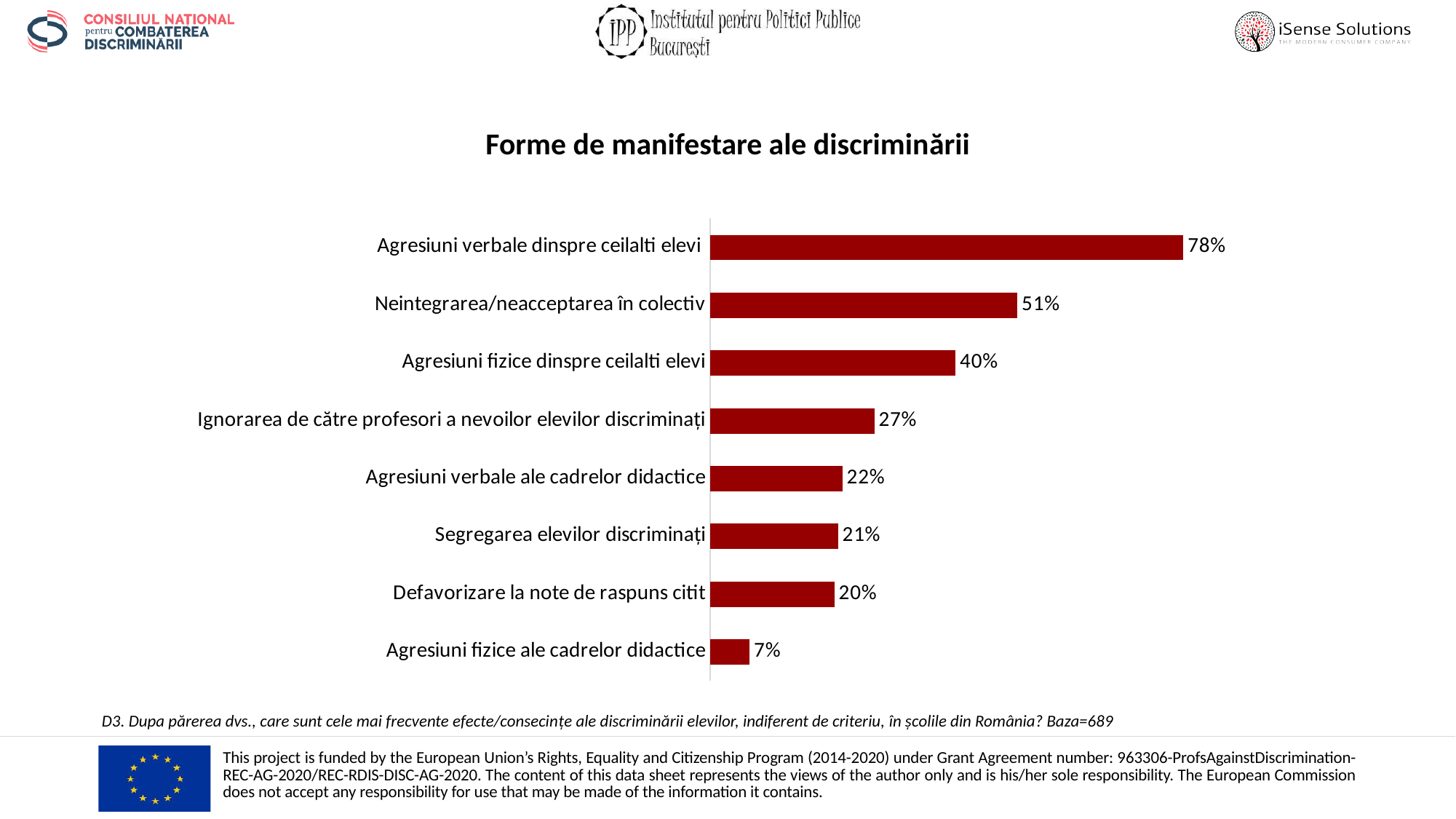
Which category has the lowest value? Agresiuni fizice ale cadrelor didactice What is the difference between the values for "Neintegrarea/neacceptarea în colectiv" and "Segregarea elevilor discriminați"? 30% How many categories are shown in the chart? 8 What is the difference between the values for "Agresiuni verbale dinspre ceilalti elevi" and "Agresiuni fizice dinspre ceilalti elevi"? 38% Which category has the highest value? Agresiuni verbale dinspre ceilalti elevi What is the value for "Ignorarea de către profesori a nevoilor elevilor discriminați"? 27% What is the value for "Agresiuni fizice ale cadrelor didactice"? 7% What is the value for "Agresiuni verbale dinspre ceilalti elevi"? 78% What kind of chart is shown on the slide? Bar chart What is the value for "Neintegrarea/neacceptarea în colectiv"? 51% What is the title of the chart? Forme de manifestare ale discriminării Which is larger: the value for "Agresiuni verbale ale cadrelor didactice" or the value for "Defavorizare la note de raspuns citit"? Agresiuni verbale ale cadrelor didactice